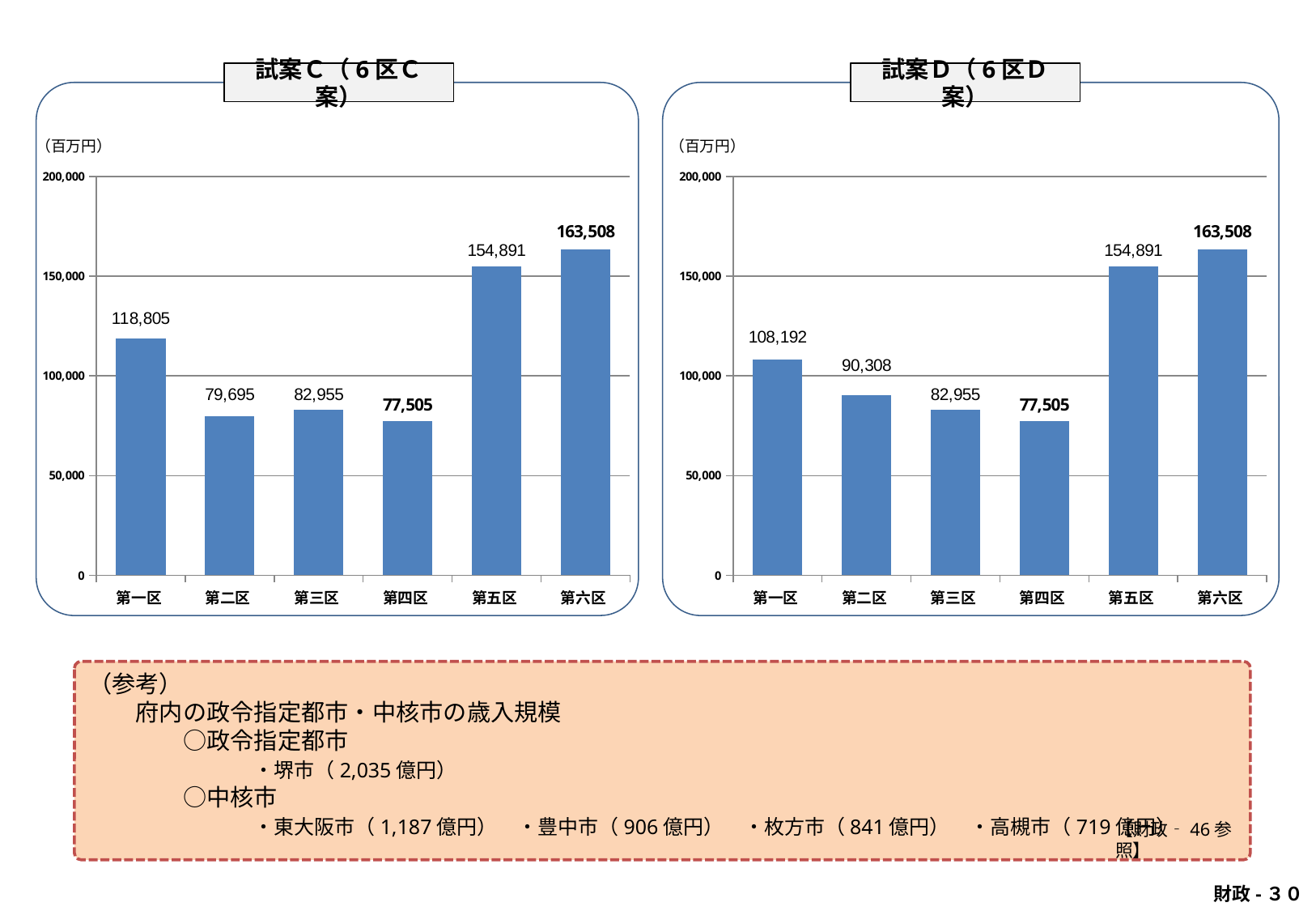
In the 試案C（6区C案） chart, is the value for 第五区 greater or less than 150,000? greater What is the difference between the 第一区 value in the 試案C（6区C案） chart and the 第一区 value in the 試案D（6区D案） chart? 10,613 In the 試案C（6区C案） chart, what is the value for 第一区? 118,805 In the 試案D（6区D案） chart, what is the value for 第四区? 77,505 In the 試案D（6区D案） chart, which district has the lowest value? 第四区 How many districts are shown on the x axis of the 試案D（6区D案） chart? 6 What kind of chart is the 試案C（6区C案） chart? bar chart What unit is shown above the y axis of the 試案C（6区C案） chart? 百万円 In the 試案D（6区D案） chart, which is larger, the value for 第二区 or the value for 第三区? 第二区 In the 試案C（6区C案） chart, which district has the highest value? 第六区 In the 試案C（6区C案） chart, what is the difference between the values for 第六区 and 第五区? 8,617 In the 試案D（6区D案） chart, what is the value for 第二区? 90,308